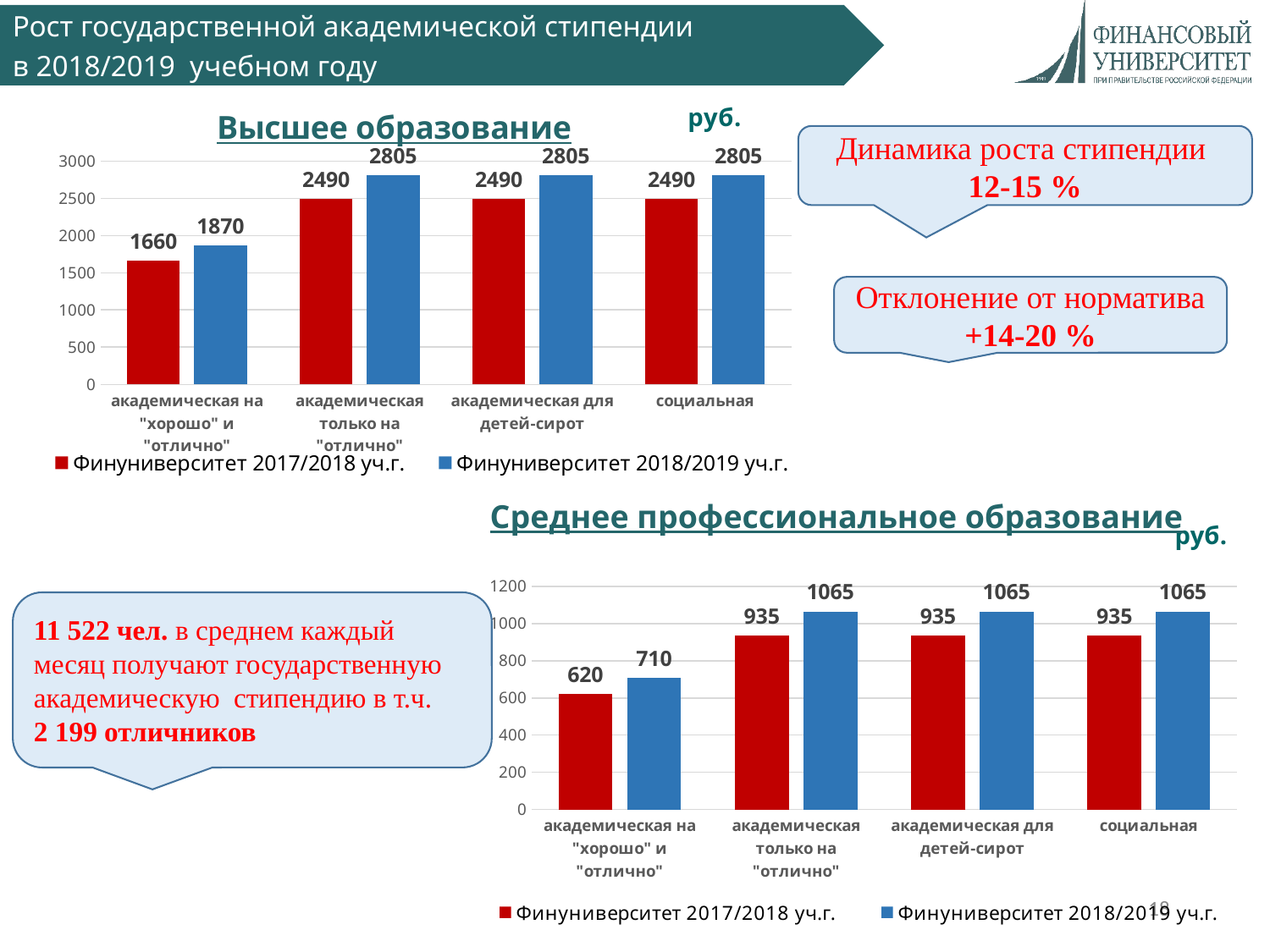
In the chart titled "Среднее профессиональное образование", which is larger: the 2017/2018 value for "академическая только на "отлично"" or the 2018/2019 value for "академическая на "хорошо" и "отлично""? 2017/2018 value for "академическая только на "отлично"" In the chart titled "Высшее образование", what is the value for "социальная" in the series "Финуниверситет 2017/2018 уч.г."? 2490 In the chart titled "Высшее образование", what is the value for "академическая на "хорошо" и "отлично"" in the series "Финуниверситет 2018/2019 уч.г."? 1870 In the chart titled "Среднее профессиональное образование", what is the difference between the 2018/2019 and 2017/2018 values for "социальная"? 130 In the chart titled "Высшее образование", which colour represents the series "Финуниверситет 2018/2019 уч.г."? blue In the chart titled "Высшее образование", what is the difference between the 2018/2019 and 2017/2018 values for "академическая только на "отлично""? 315 In the chart titled "Среднее профессиональное образование", what is the value for "академическая для детей-сирот" in the series "Финуниверситет 2018/2019 уч.г."? 1065 In the chart titled "Высшее образование", which category has the lowest value in the series "Финуниверситет 2017/2018 уч.г."? академическая на "хорошо" и "отлично" In the chart titled "Высшее образование", how many series does the legend list? 2 In the chart titled "Среднее профессиональное образование", what is the value for "академическая на "хорошо" и "отлично"" in the series "Финуниверситет 2017/2018 уч.г."? 620 In the chart titled "Среднее профессиональное образование", how many categories are shown on the x axis? 4 What type of chart is the chart titled "Среднее профессиональное образование"? bar chart